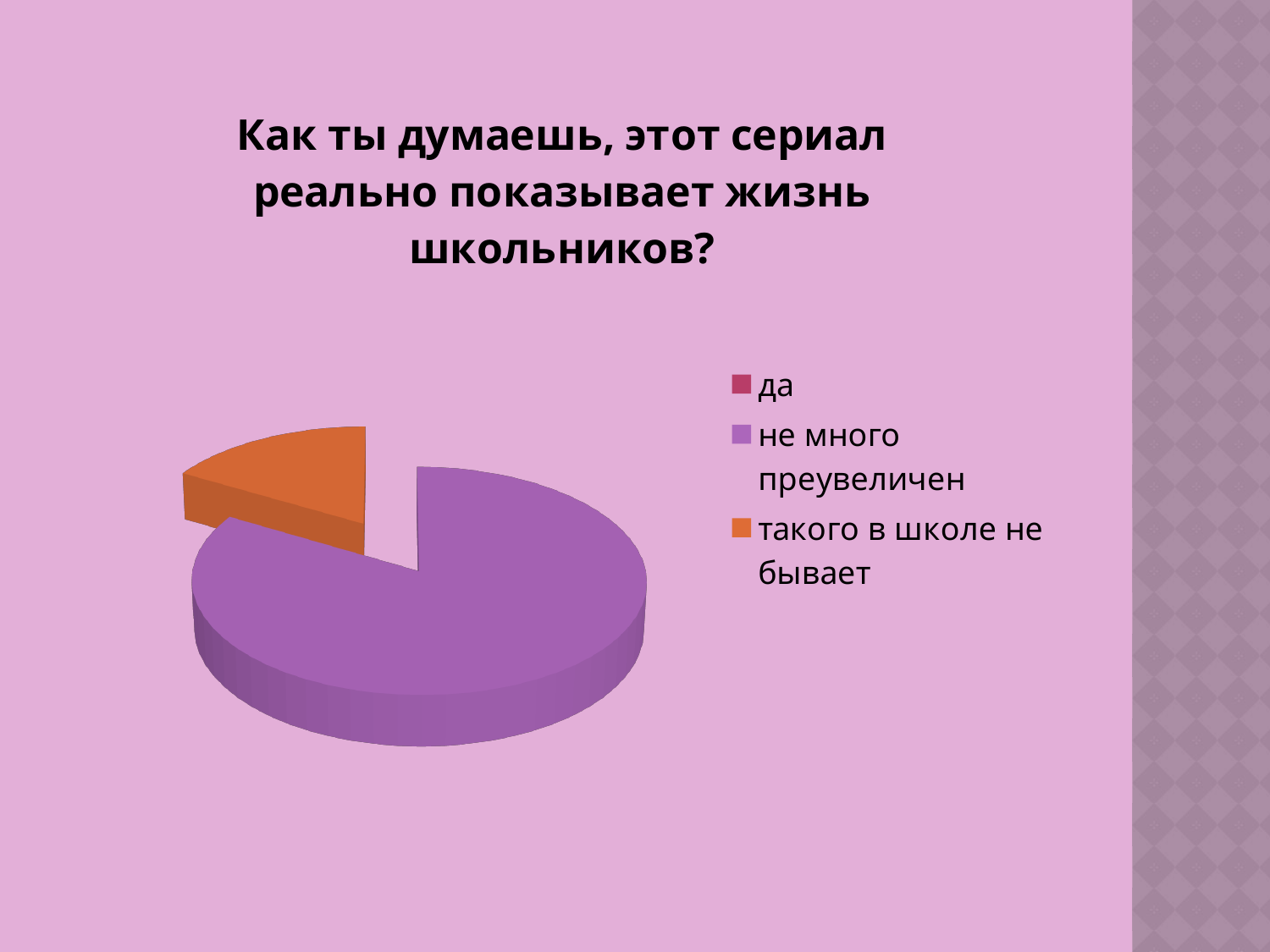
What kind of chart is shown on the slide? pie chart Which category has the largest slice of the pie? не много преувеличен Which slice is larger: "не много преувеличен" or "такого в школе не бывает"? не много преувеличен Which category is shown in orange in the legend? такого в школе не бывает Is the share of "не много преувеличен" greater or less than 50%? greater What is the title of the chart? Как ты думаешь, этот сериал реально показывает жизнь школьников? Is the share of "такого в школе не бывает" greater or less than 50%? less How many categories does the chart's legend list? 3